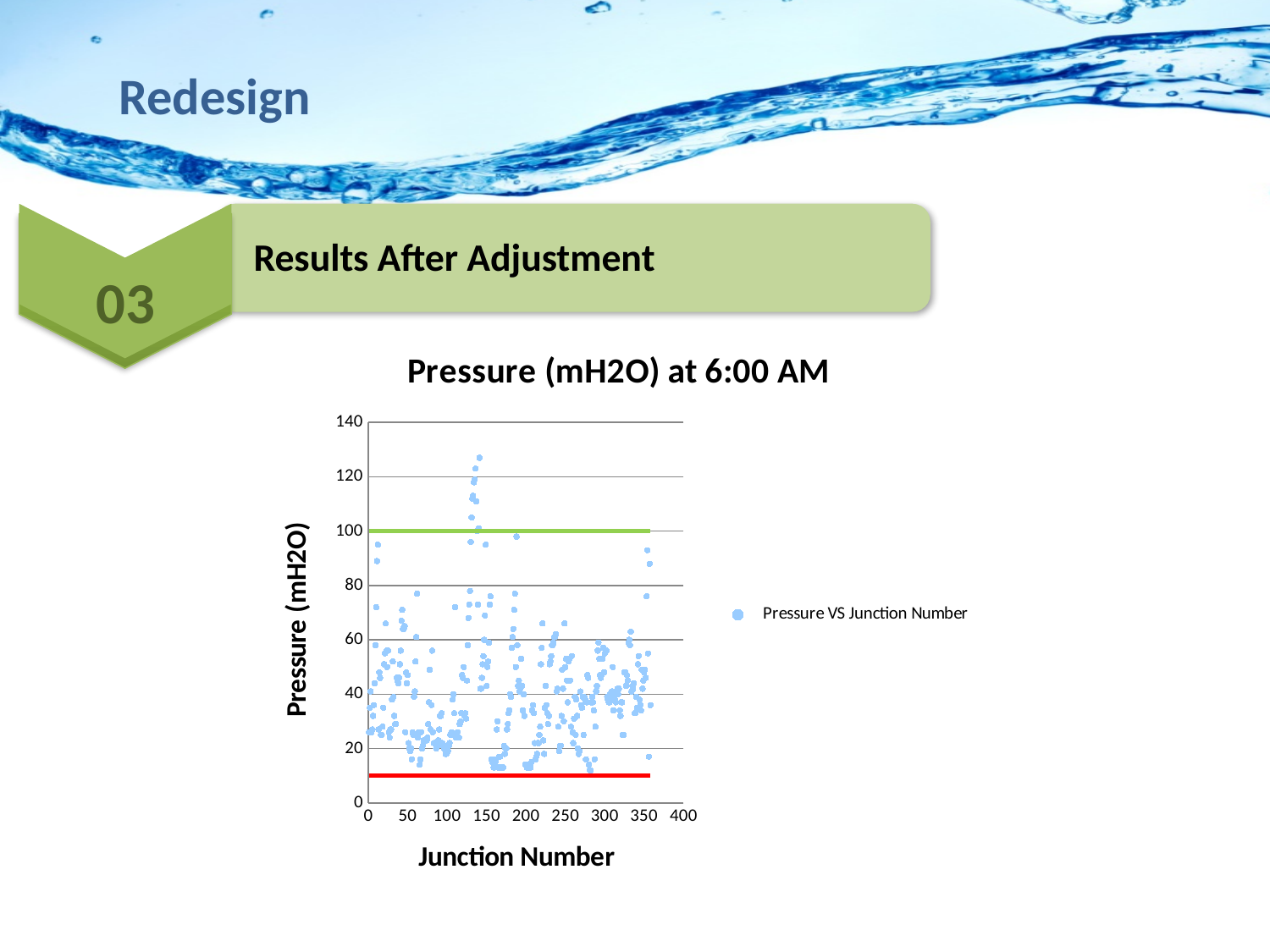
What is the label of the vertical axis? Pressure (mH2O) What kind of chart is shown on the slide? Scatter chart What is the maximum value shown on the vertical axis? 140 Is the red horizontal line greater or less than 20 on the pressure axis? less At what pressure value is the green horizontal line drawn? 100 What is the title of the chart? Pressure (mH2O) at 6:00 AM Is the highest plotted pressure value greater or less than 120? greater What is the maximum value shown on the horizontal axis? 400 What is the name of the series shown in the legend? Pressure VS Junction Number Are most of the plotted points above or below the green line at 100? below How many series does the chart legend list? 1 What is the label of the horizontal axis? Junction Number